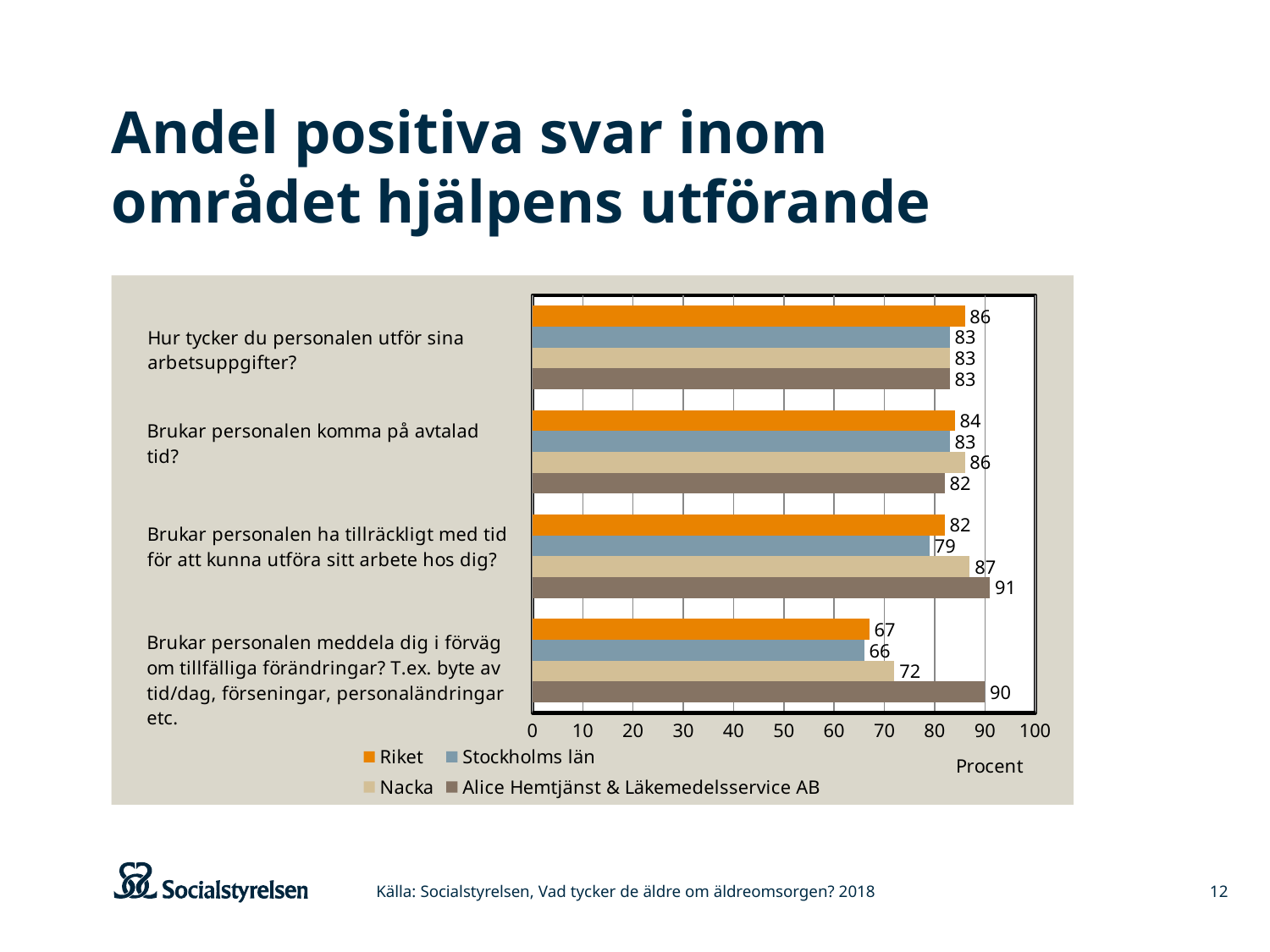
What is the value for Riket for "Hur tycker du personalen utför sina arbetsuppgifter?"? 86 How many series does the legend list? 4 How many question categories are plotted in the chart? 4 What type of chart is shown on the slide? Bar chart What is the value for Stockholms län for "Brukar personalen meddela dig i förväg om tillfälliga förändringar?"? 66 What is the value for Alice Hemtjänst & Läkemedelsservice AB for "Brukar personalen ha tillräckligt med tid för att kunna utföra sitt arbete hos dig?"? 91 What is the value for Nacka for "Brukar personalen komma på avtalad tid?"? 86 Which series has the lowest value for "Brukar personalen ha tillräckligt med tid för att kunna utföra sitt arbete hos dig?"? Stockholms län For "Brukar personalen komma på avtalad tid?", which is larger: the value for Nacka or the value for Alice Hemtjänst & Läkemedelsservice AB? Nacka What label is shown on the horizontal axis of the chart? Procent What is the difference between Alice Hemtjänst & Läkemedelsservice AB and Riket for "Brukar personalen meddela dig i förväg om tillfälliga förändringar?"? 23 Which series has the highest value for "Brukar personalen meddela dig i förväg om tillfälliga förändringar?"? Alice Hemtjänst & Läkemedelsservice AB